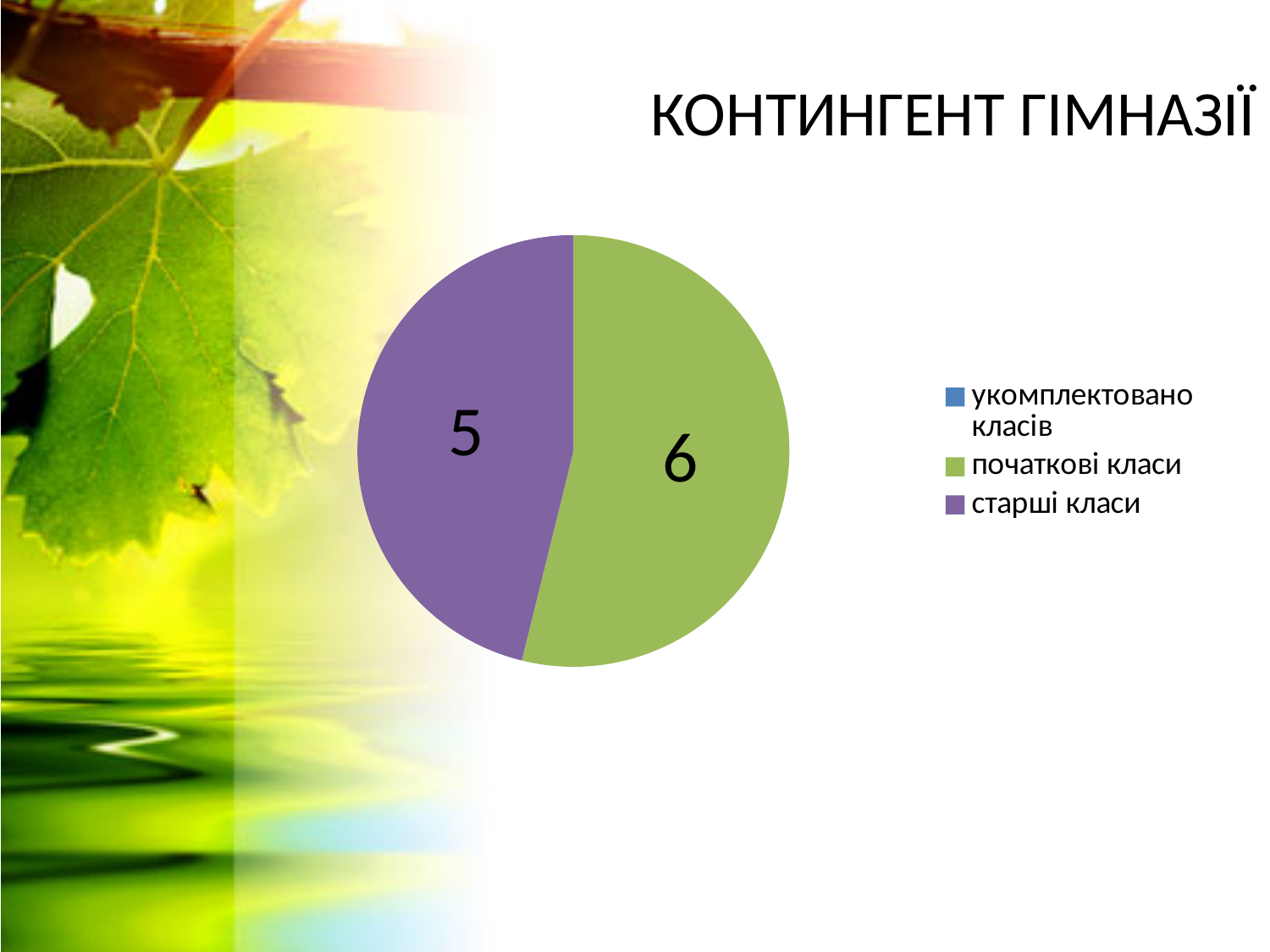
How many entries does the chart legend list? 3 Which is larger: початкові класи or старші класи? початкові класи What is the title of the slide with the chart? КОНТИНГЕНТ ГІМНАЗІЇ What is the difference between the values for початкові класи and старші класи? 1 What is the value for старші класи in the pie chart? 5 What kind of chart is shown on the slide? pie chart What is the value for початкові класи in the pie chart? 6 What colour is the slice for старші класи? purple What is the total of the two values shown in the pie chart? 11 How many slices does the pie chart show? 2 Which slice of the pie chart has the largest value? початкові класи Which slice of the pie chart has the smallest value? старші класи